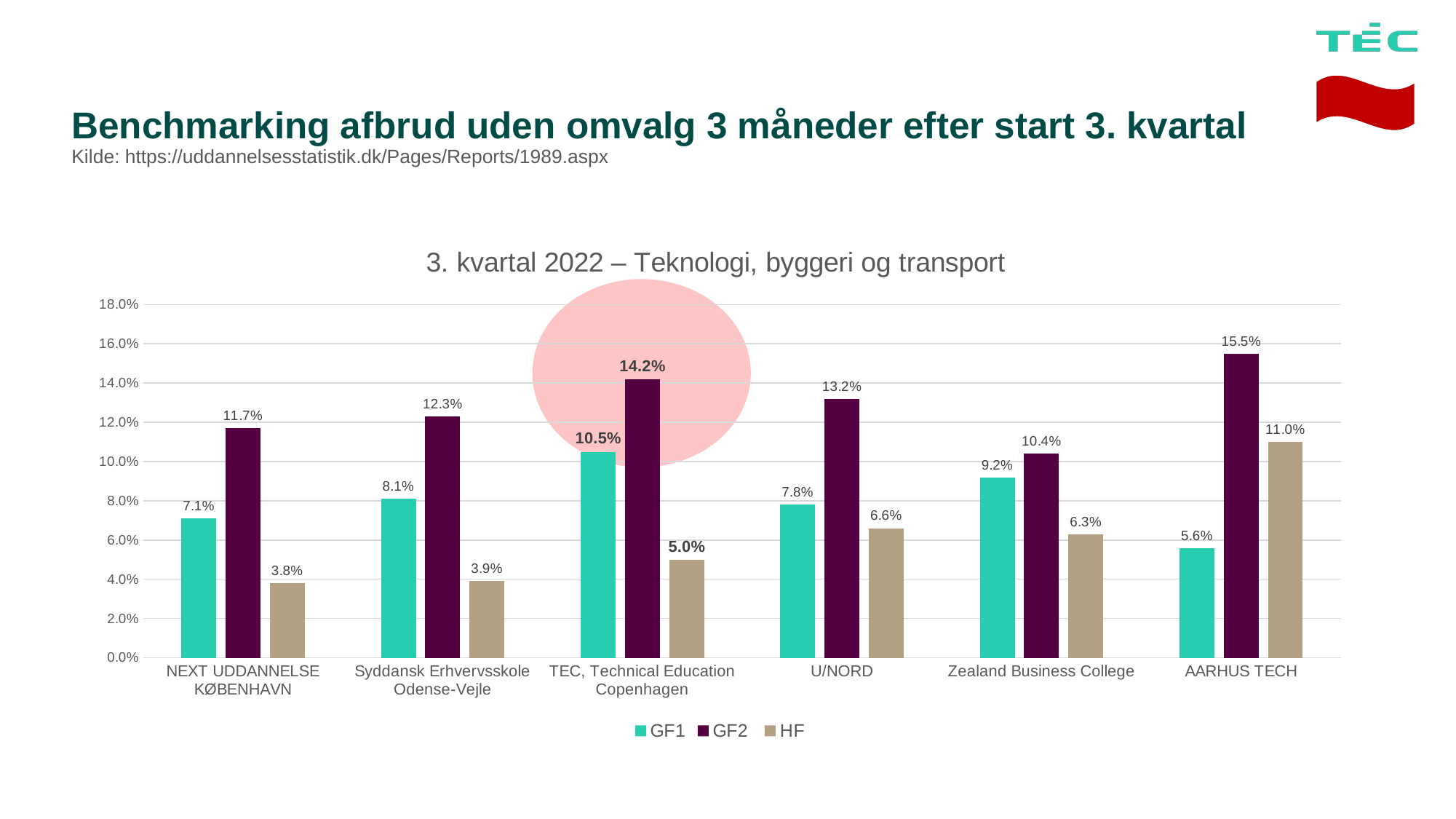
Which is larger for Syddansk Erhvervsskole Odense-Vejle: the GF1 value or the HF value? GF1 What is the title of the chart? 3. kvartal 2022 – Teknologi, byggeri og transport How many series does the legend list? 3 Which institution has the highest GF2 value? AARHUS TECH How many institutions are shown on the x axis? 6 Which institution has the lowest HF value? NEXT UDDANNELSE KØBENHAVN Which institution has the highest GF1 value? TEC, Technical Education Copenhagen What is the HF value for AARHUS TECH? 11.0% What is the GF1 value for Zealand Business College? 9.2% What is the difference between the GF2 and GF1 values for U/NORD? 5.4% What is the GF2 value for TEC, Technical Education Copenhagen? 14.2% What kind of chart is shown on the slide? Bar chart